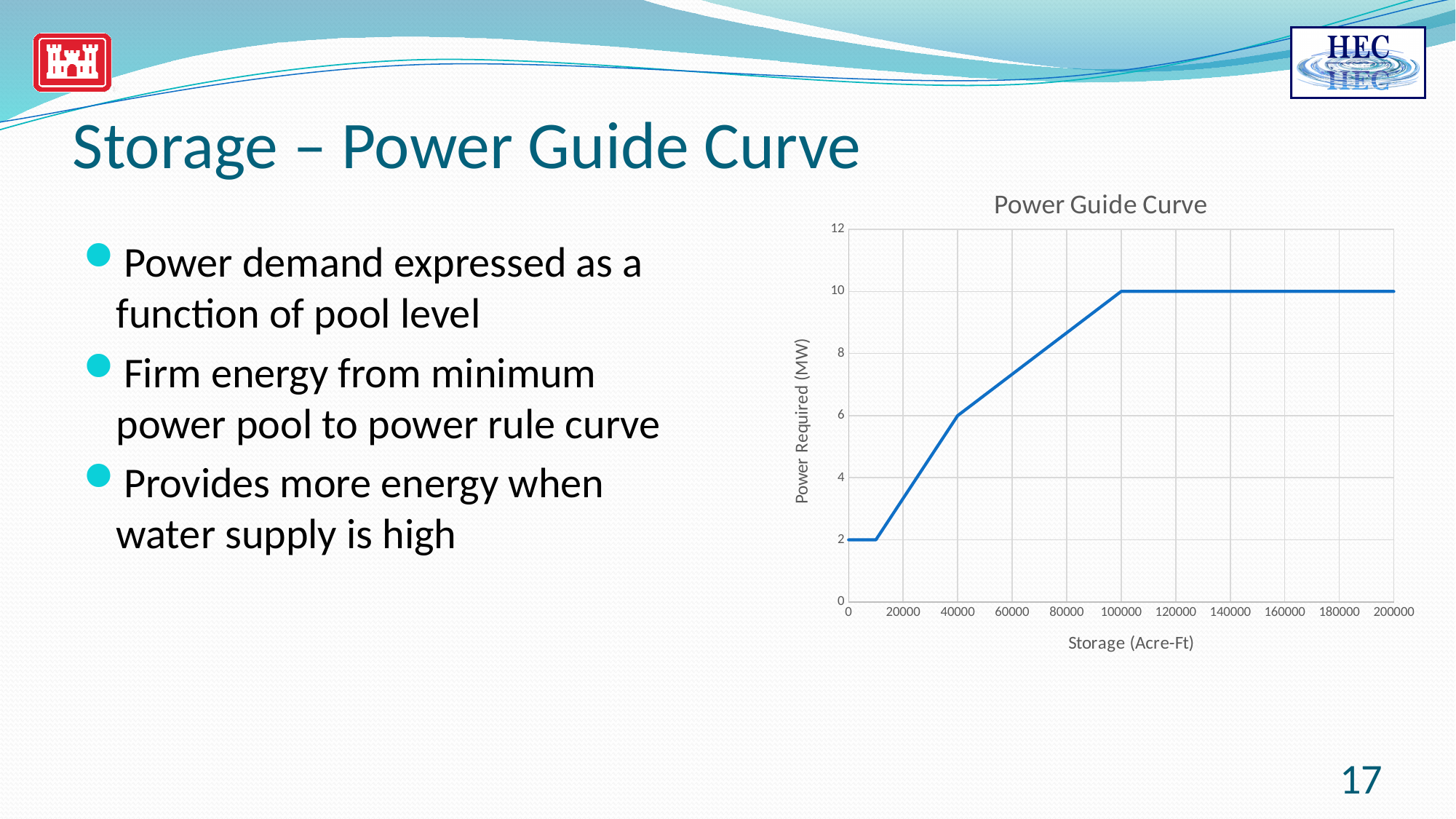
What kind of chart is the Power Guide Curve? line chart What is the difference in power required between a storage of 100000 and 40000 acre-ft? 4 What is the label of the y axis? Power Required (MW) Does the power required rise or fall as storage increases from 20000 to 100000 acre-ft? rise What is the title of the chart? Power Guide Curve What is the maximum power required shown on the curve? 10 What is the power required at a storage of 200000 acre-ft? 10 Is the power required at a storage of 60000 acre-ft greater or less than 6? greater What is the power required at a storage of 40000 acre-ft? 6 What is the minimum power required shown on the curve? 2 What is the power required at a storage of 100000 acre-ft? 10 What is the power required at a storage of 0 acre-ft? 2